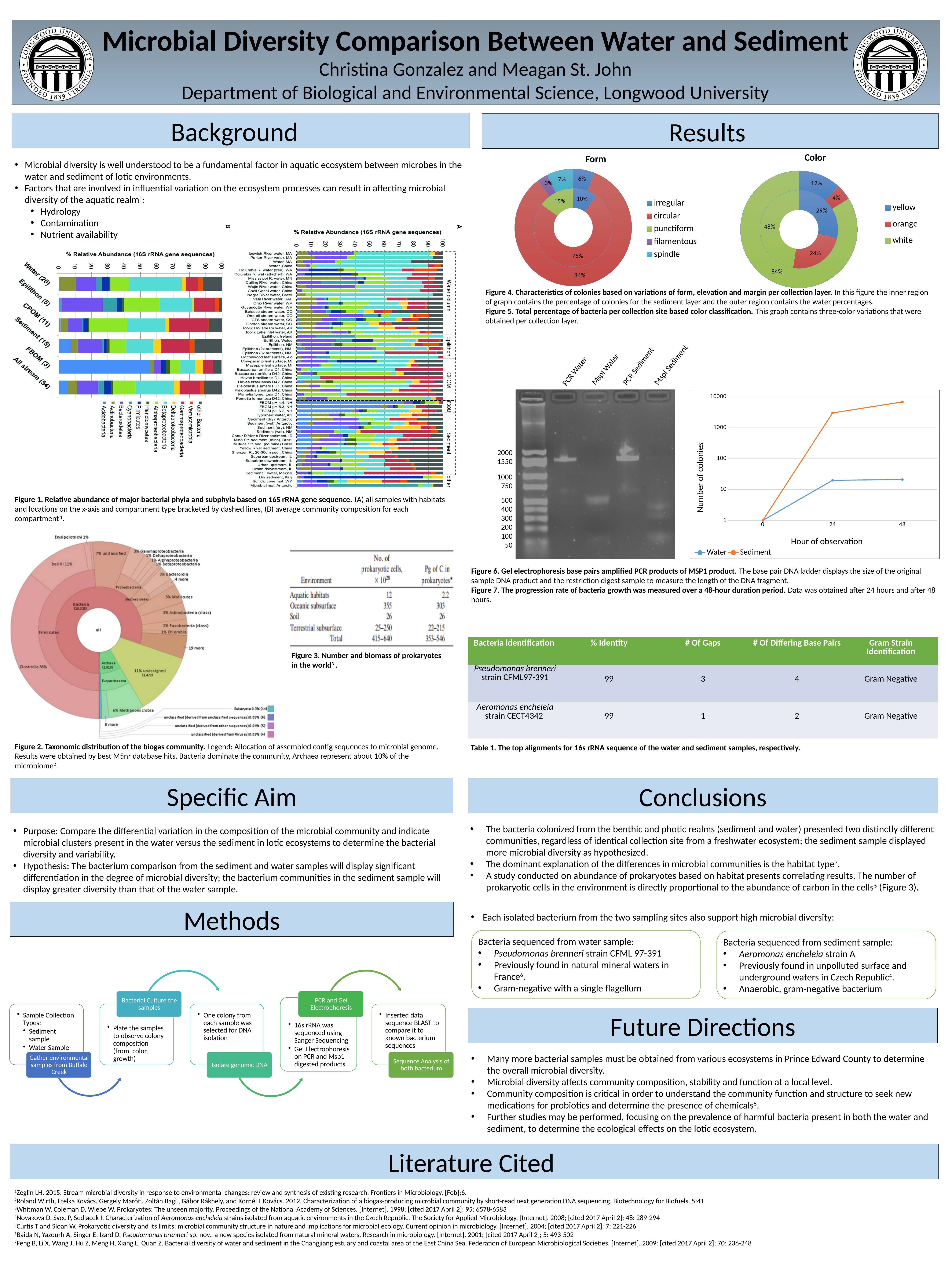
In the Form doughnut chart, how many colony forms does the legend list? 5 In the line chart of number of colonies versus hour of observation, is the Sediment value at 48 hours greater or less than 1000? greater In the Form doughnut chart, what percentage does the inner ring show for punctiform colonies? 15% In the Color doughnut chart, how many colours does the legend list? 3 In the Color doughnut chart, what percentage does the outer ring show for white colonies? 84% In the Color doughnut chart, what percentage does the inner ring show for yellow colonies? 29% In the Form doughnut chart, which colony form has the largest share in the outer ring? circular In the Form doughnut chart, what percentage does the inner ring show for circular colonies? 75% In the Form doughnut chart, what percentage does the outer ring show for circular colonies? 84% In the Color doughnut chart, what is the difference between the inner-ring percentages for white and orange colonies? 24% In the Color doughnut chart, which colour has the smallest share in the outer ring? orange In the line chart of number of colonies versus hour of observation, which series has the higher value at 24 hours, Water or Sediment? Sediment